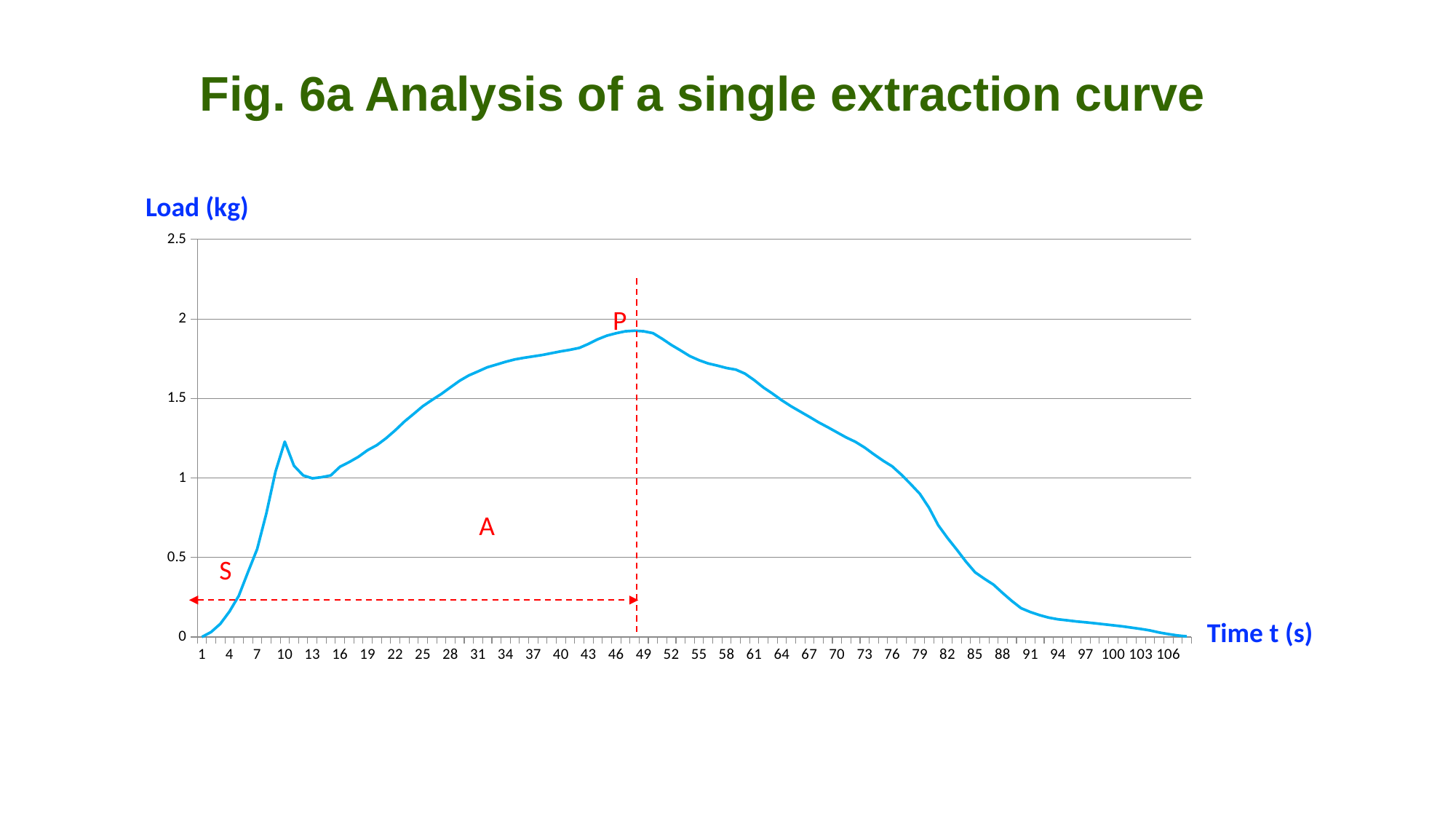
Is the load at time 4 greater or less than 0.5? less What is the label of the vertical axis? Load (kg) What is the title of the chart? Fig. 6a Analysis of a single extraction curve Is the load at time 49 greater or less than 1.5? greater Is the load at time 70 greater or less than 1.5? less What kind of chart is shown on the slide? line chart Which labelled point marks the maximum of the curve? P Between time 49 and time 106, does the load rise or fall? fall